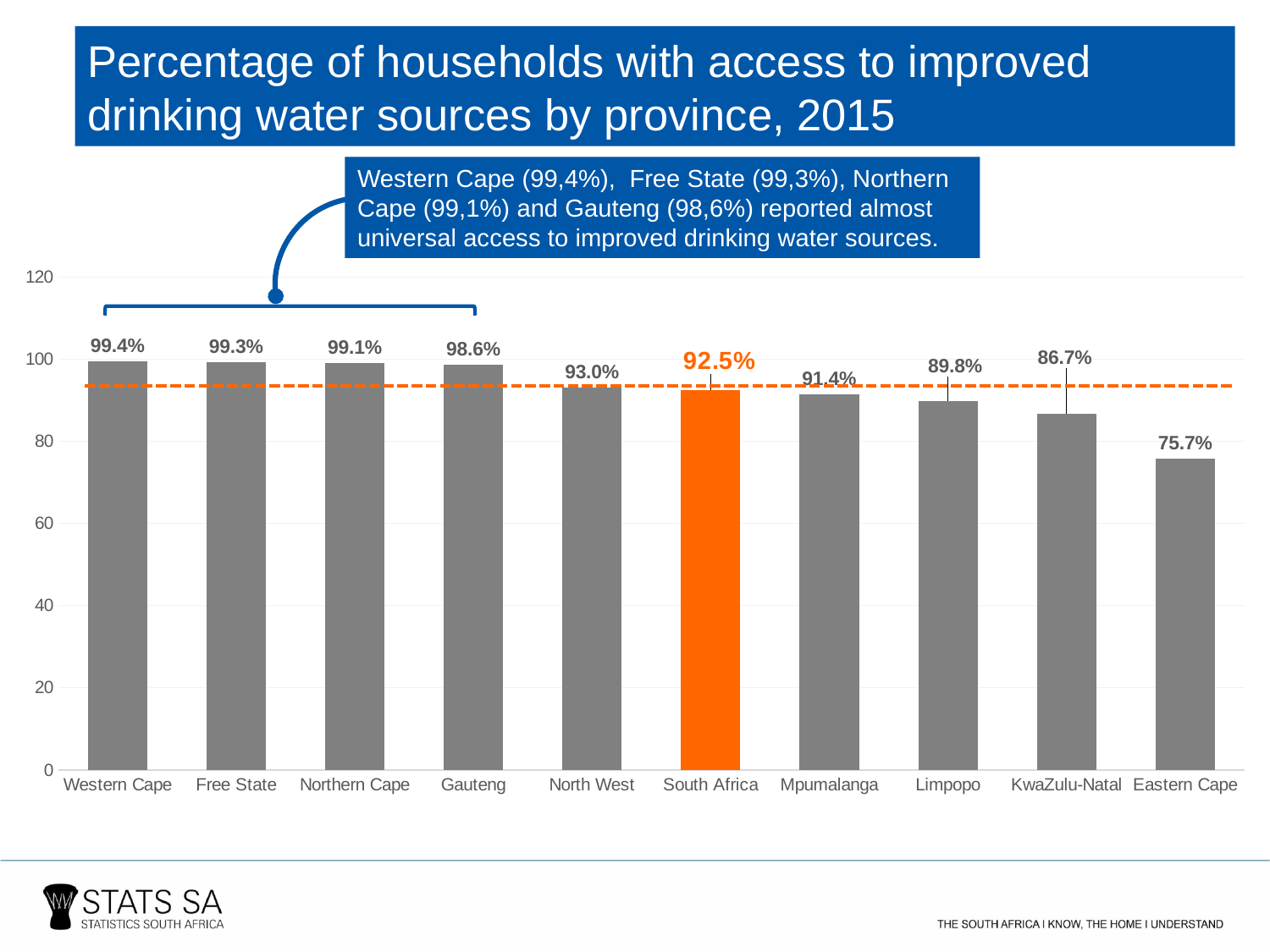
Which is larger, the value for KwaZulu-Natal or the value for Mpumalanga? Mpumalanga What kind of chart is shown on the slide? bar chart What is the value for Eastern Cape? 75.7% What is the difference between the values for Western Cape and Eastern Cape? 23.7% What is the value for South Africa? 92.5% What is the value for Limpopo? 89.8% Which bar is coloured orange? South Africa How many categories are shown on the x axis? 10 Which category has the highest value? Western Cape Is the value for Eastern Cape greater or less than 80? less What is the value for Western Cape? 99.4% Which category has the lowest value? Eastern Cape